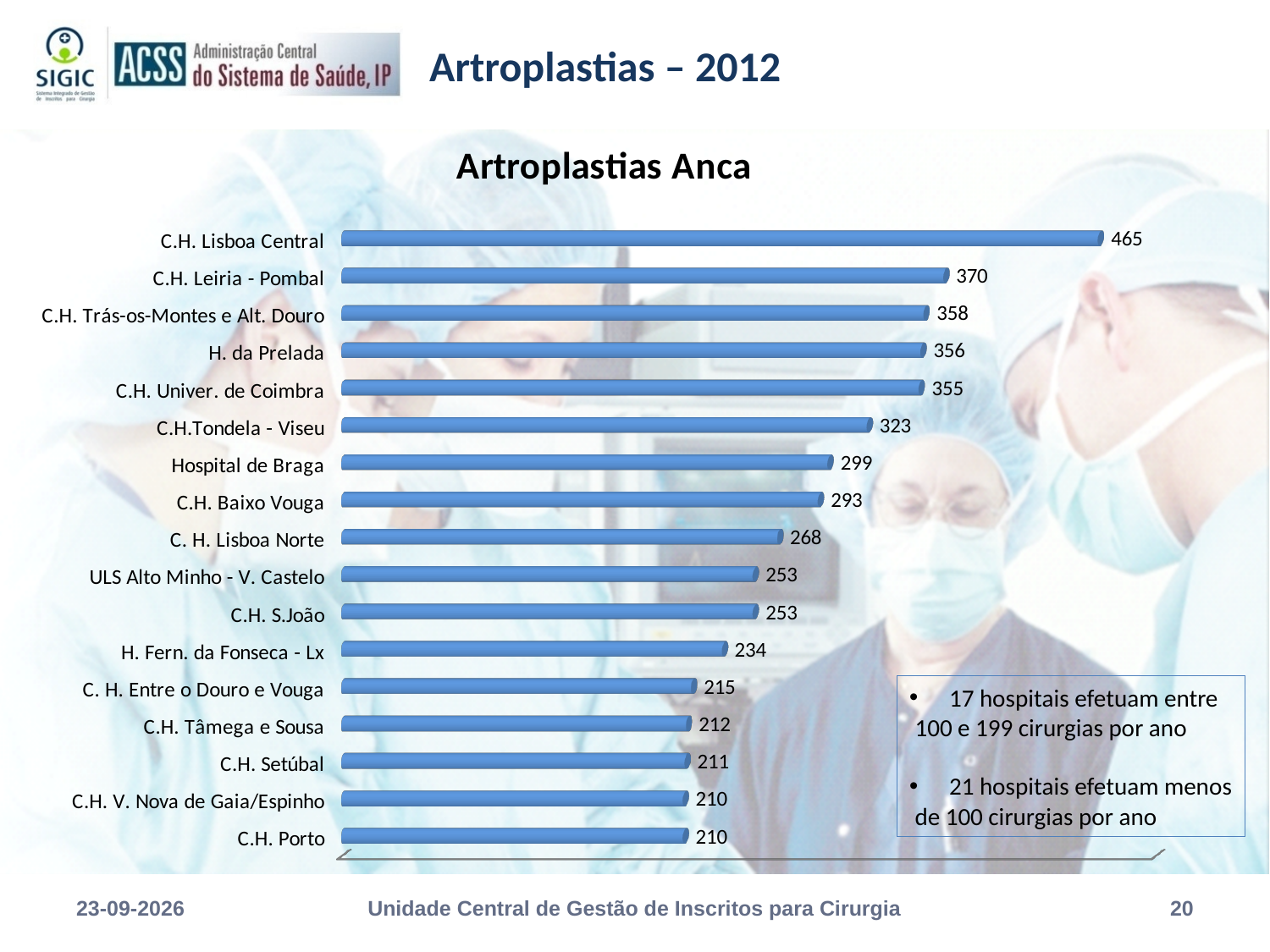
What is the value for Hospital de Braga? 299 Which hospital has the highest value in the chart? C.H. Lisboa Central What kind of chart is shown on the slide? bar chart What is the value for C.H. Porto? 210 What is the value for H. Fern. da Fonseca - Lx? 234 What is the difference between the values for C.H. Lisboa Central and C.H. Leiria - Pombal? 95 What is the difference between the values for C. H. Lisboa Norte and C.H. S.João? 15 Which is larger, the value for C.H.Tondela - Viseu or the value for C.H. Baixo Vouga? C.H.Tondela - Viseu What is the value for C.H. Leiria - Pombal? 370 Which is larger, the value for H. da Prelada or the value for C.H. Univer. de Coimbra? H. da Prelada How many hospitals are listed in the chart? 17 What is the title of the chart? Artroplastias Anca